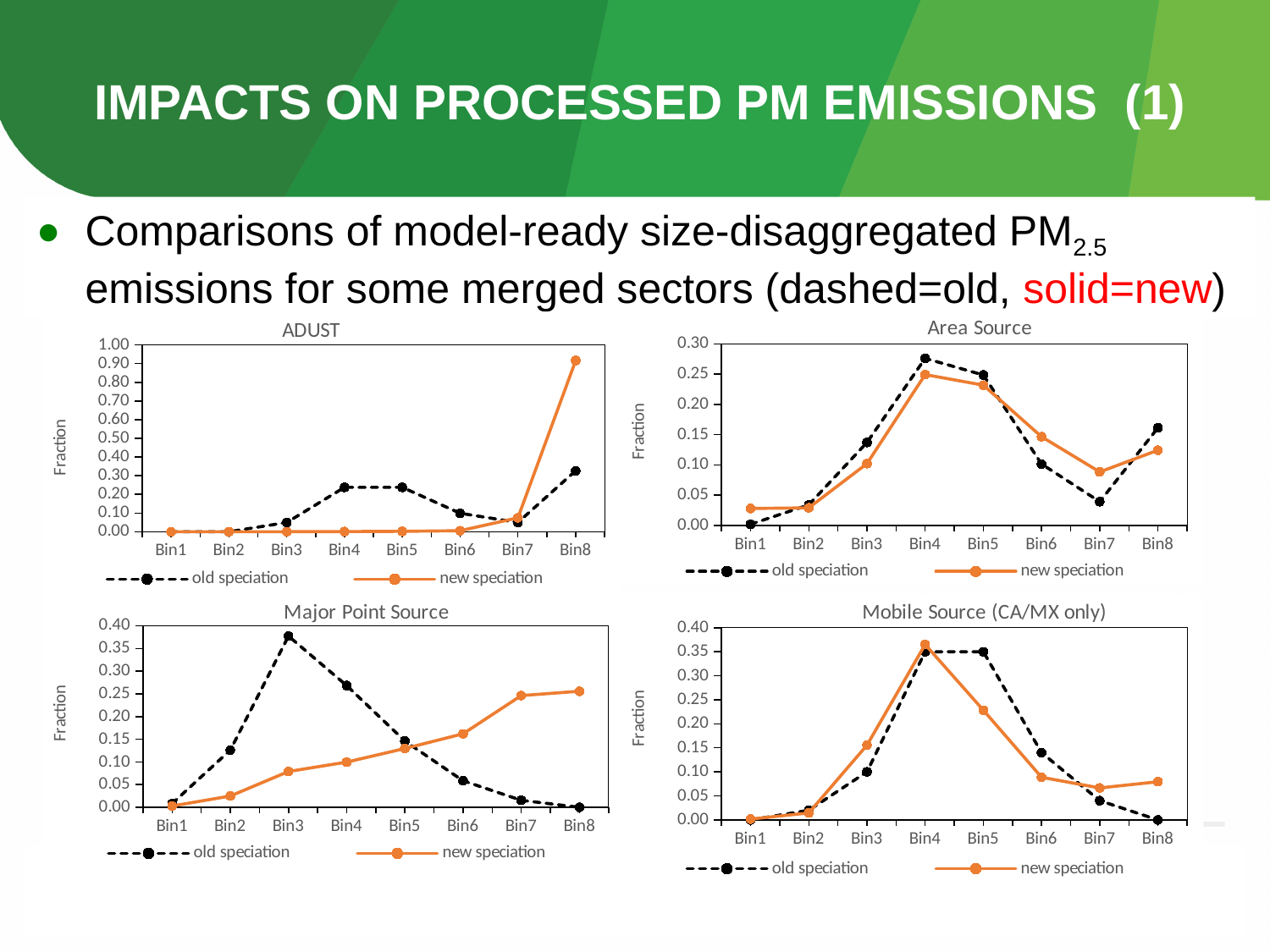
How many bins are shown on the x axis of the Major Point Source chart? 8 How many series does the legend of the Area Source chart list? 2 In the Area Source chart, is the old speciation value at Bin7 greater or less than 0.05? less In the Area Source chart, at which bin does the old speciation series reach its highest value? Bin4 In the Major Point Source chart, at which bin does the old speciation series reach its highest value? Bin3 Which of the four charts has a y axis that goes up to 1.00? ADUST In the Mobile Source (CA/MX only) chart, which series has the larger value at Bin5, old speciation or new speciation? old speciation In the ADUST chart, at which bin does the new speciation series reach its highest value? Bin8 What kind of chart is the ADUST chart? line chart In the Mobile Source (CA/MX only) chart, does the old speciation series rise or fall from Bin5 to Bin8? fall In the Major Point Source chart, which series has the larger value at Bin7, old speciation or new speciation? new speciation In the ADUST chart, is the new speciation value at Bin8 greater or less than 0.80? greater